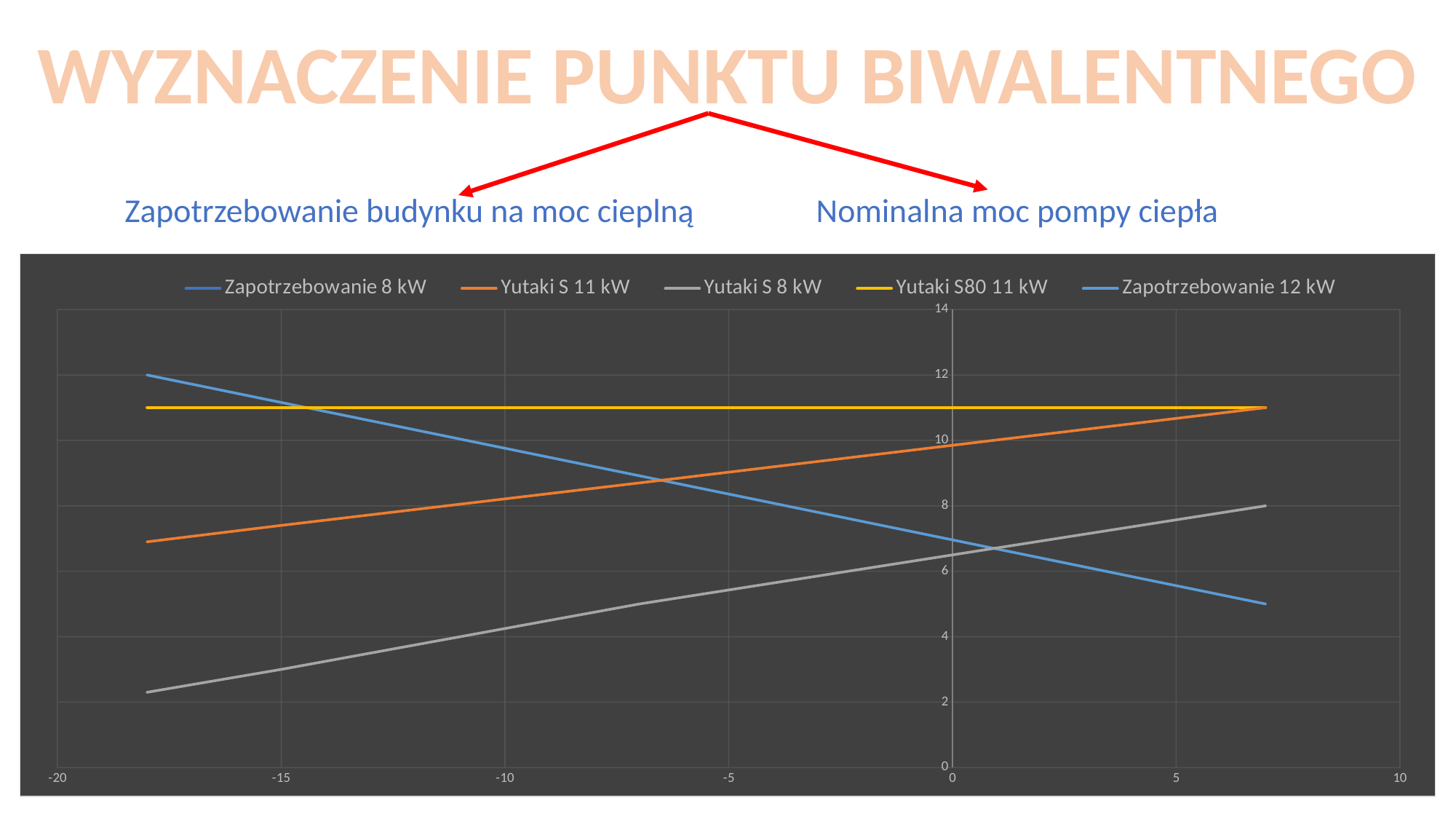
What colour is the Yutaki S80 11 kW line in the chart? yellow At x = 0, which line is higher: Yutaki S80 11 kW or Yutaki S 8 kW? Yutaki S80 11 kW Does the Yutaki S80 11 kW line rise, fall or stay flat along the x axis? stays flat Is the value of the Yutaki S80 11 kW line greater or less than 10? greater Which series has the lowest value at x = -15? Yutaki S 8 kW What type of chart is shown on the slide? line chart At x = -10, which line is higher: Yutaki S 11 kW or Yutaki S 8 kW? Yutaki S 11 kW Does the Yutaki S 8 kW line rise or fall as the x-axis value increases? rises How many series does the chart legend list? 5 Is the value of the Yutaki S 8 kW line at x = -15 greater or less than 4? less Is the value of the Yutaki S 11 kW line at x = -15 greater or less than 6? greater Does the Yutaki S 11 kW line rise or fall as the x-axis value increases? rises